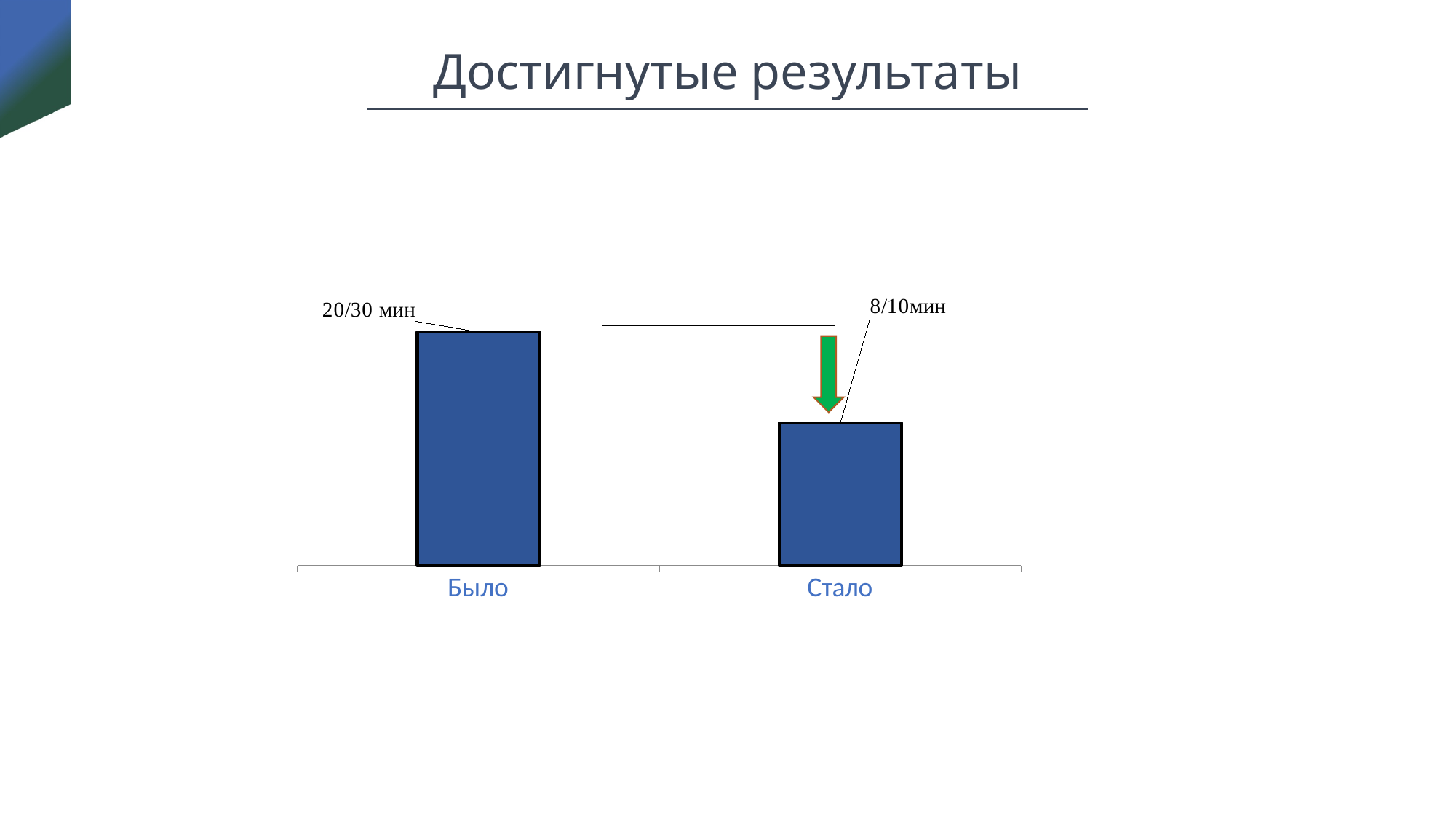
Which category has the taller bar? Было Do the bar values rise or fall from Было to Стало? fall How many bars are plotted in the chart? 2 Is the bar for Было taller or shorter than the bar for Стало? taller What kind of chart is shown on the slide? bar chart What is the title of the slide containing the chart? Достигнутые результаты Which category has the shorter bar? Стало What are the two category labels on the x axis of the chart? Было, Стало What value is labelled on the bar for Было? 20/30 мин What value is labelled on the bar for Стало? 8/10мин